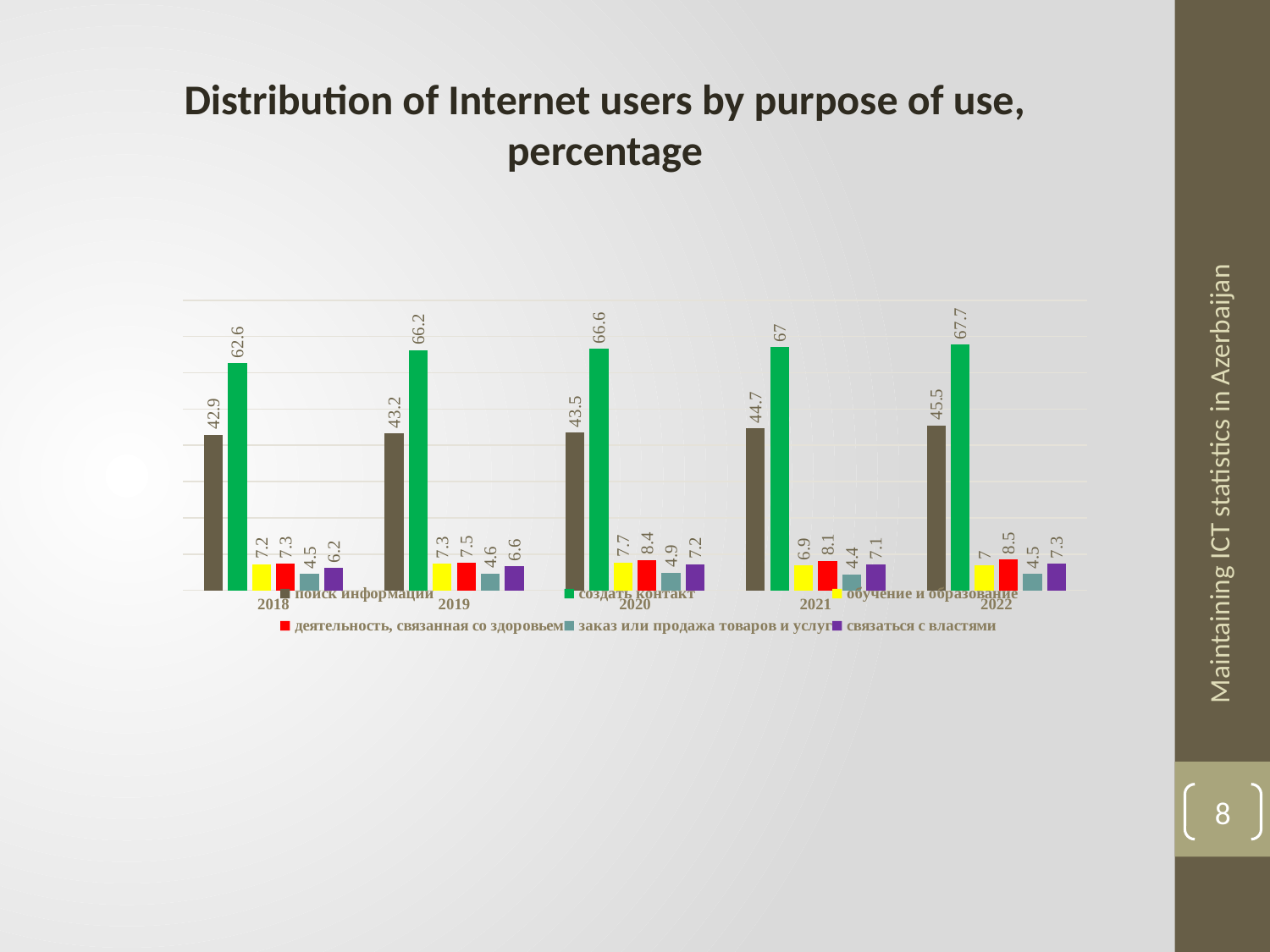
What is the value for "заказ или продажа товаров и услуг" in 2021? 4.4 What is the value for "поиск информации" in 2018? 42.9 What is the value for "деятельность, связанная со здоровьем" in 2020? 8.4 What is the value for "создать контакт" in 2022? 67.7 How many years are shown on the x axis of the chart? 5 In which year is the value for "создать контакт" the highest? 2022 Does the value for "поиск информации" rise or fall from 2018 to 2022? rise What is the difference between the "создать контакт" value and the "поиск информации" value in 2021? 22.3 In which year is the value for "поиск информации" the lowest? 2018 Which is larger in 2019: the value for "обучение и образование" or the value for "связаться с властями"? обучение и образование How many series does the chart legend list? 6 What type of chart is shown on the slide? bar chart